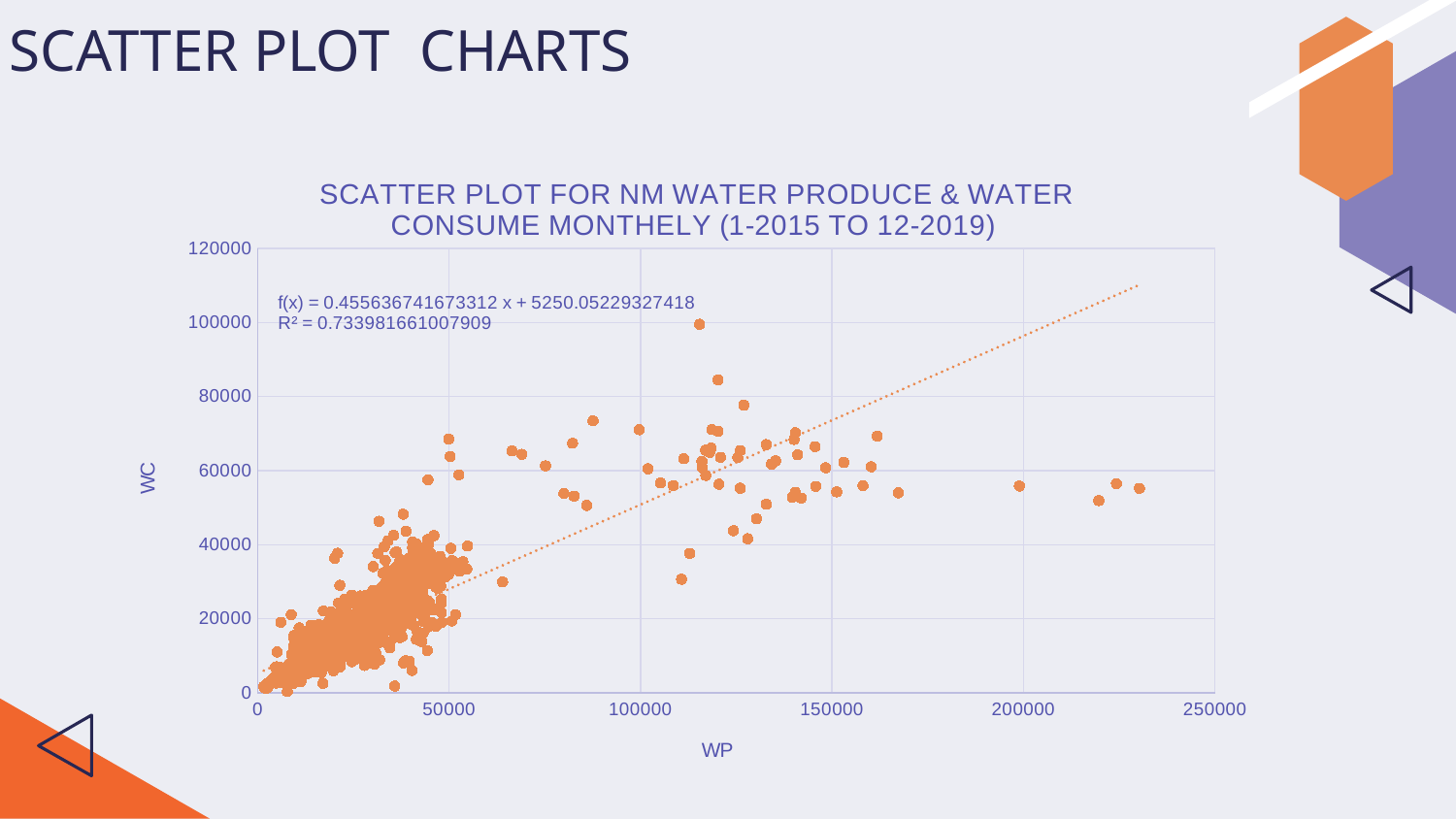
What is the trendline equation printed on the chart? f(x) = 0.455636741673312 x + 5250.05229327418 Is the highest WC value plotted greater or less than 80000? greater As WP increases along the x axis, does WC generally rise or fall? Rise What are the labels of the x axis and the y axis of the chart? WP (x axis) and WC (y axis) What is the highest tick value shown on the x axis (WP)? 250000 Is the slope of the dotted trendline positive or negative? Positive What kind of chart is shown on the slide? Scatter plot What is the R² value printed on the chart? R² = 0.733981661007909 What is the highest tick value shown on the y axis (WC)? 120000 Is the largest WP value plotted greater or less than 200000? greater Is the WC value of the point with the largest WP greater or less than 80000? less What is the title of the chart? SCATTER PLOT FOR NM WATER PRODUCE & WATER CONSUME MONTHELY (1-2015 TO 12-2019)